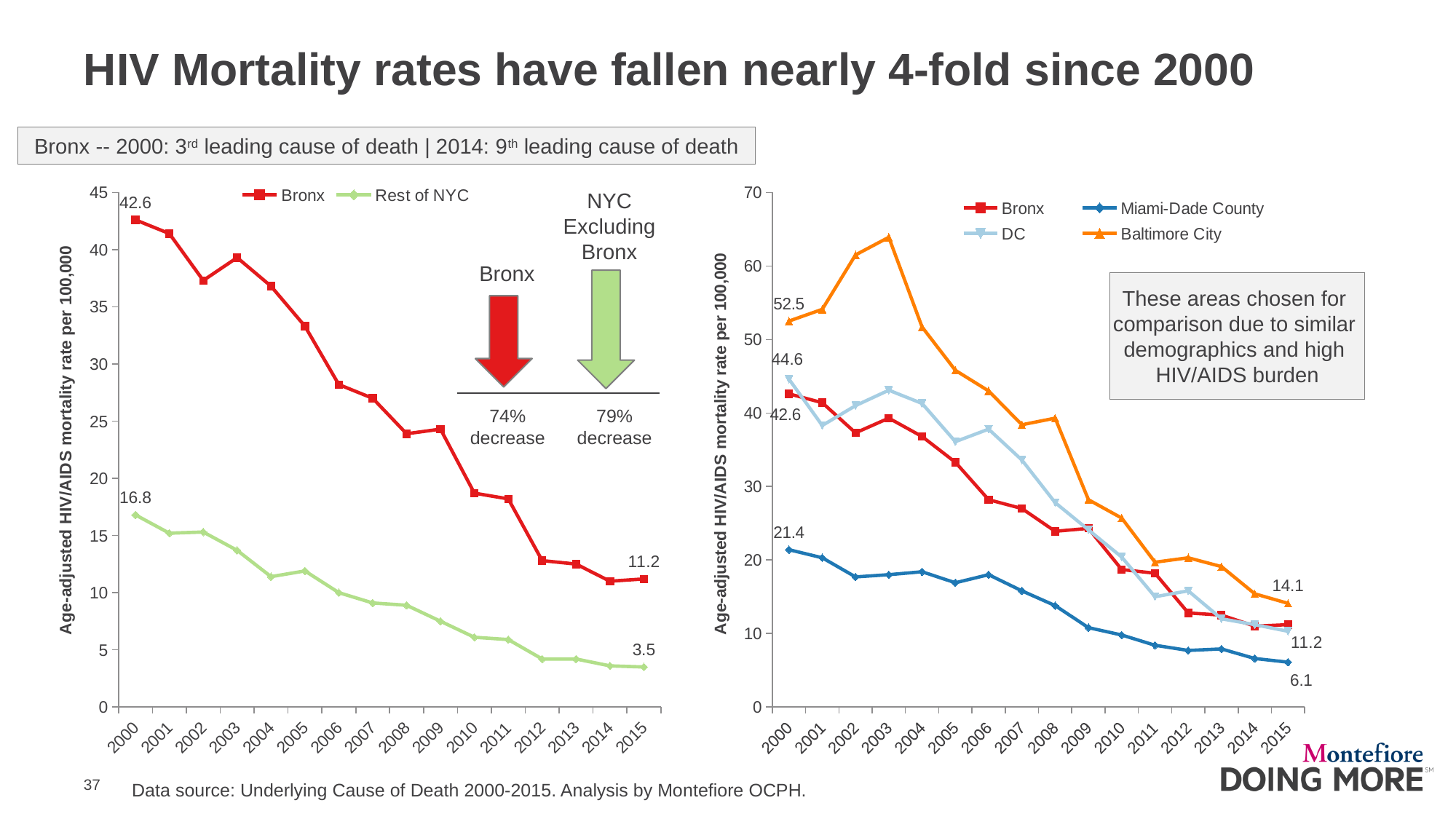
In the right chart, which series had the lowest value in 2000? Miami-Dade County In the right chart, what was the Baltimore City mortality rate in 2000? 52.5 In the right chart, how many series does the legend list? 4 In the right chart, what was the Miami-Dade County mortality rate in 2015? 6.1 In the right chart, which series had the highest value in 2003? Baltimore City In the left chart, does the Rest of NYC series rise or fall from 2000 to 2015? fall In the left chart, what was the Bronx HIV/AIDS mortality rate in 2000? 42.6 What kind of chart is the right chart? line chart In the left chart, what was the Rest of NYC mortality rate in 2015? 3.5 In the left chart, is the Bronx value for 2005 greater or less than 30? greater In the left chart, how many series does the legend list? 2 In the left chart, what is the difference between the Bronx rate in 2000 and the Bronx rate in 2015? 31.4